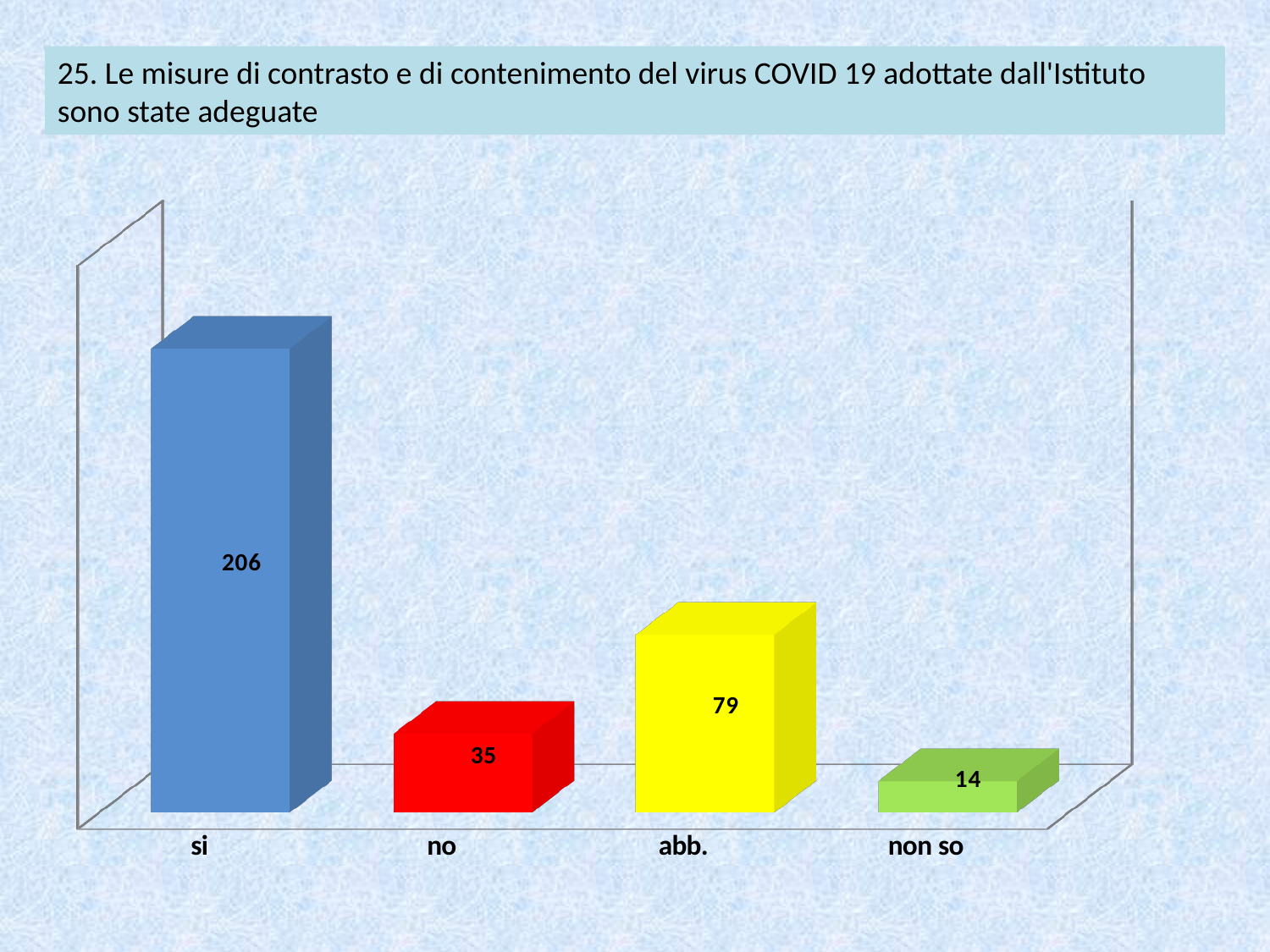
What is the difference between the values for "no" and "non so"? 21 What is the value for "no"? 35 Which is larger, the value for "no" or the value for "abb."? abb. How many categories are shown on the x axis? 4 Which category has the lowest value? non so What kind of chart is shown on the slide? bar chart What is the value for "abb."? 79 Which category has the highest value? si What is the difference between the values for "si" and "abb."? 127 What is the value for "si"? 206 What is the value for "non so"? 14 What colour is the bar for "abb."? yellow